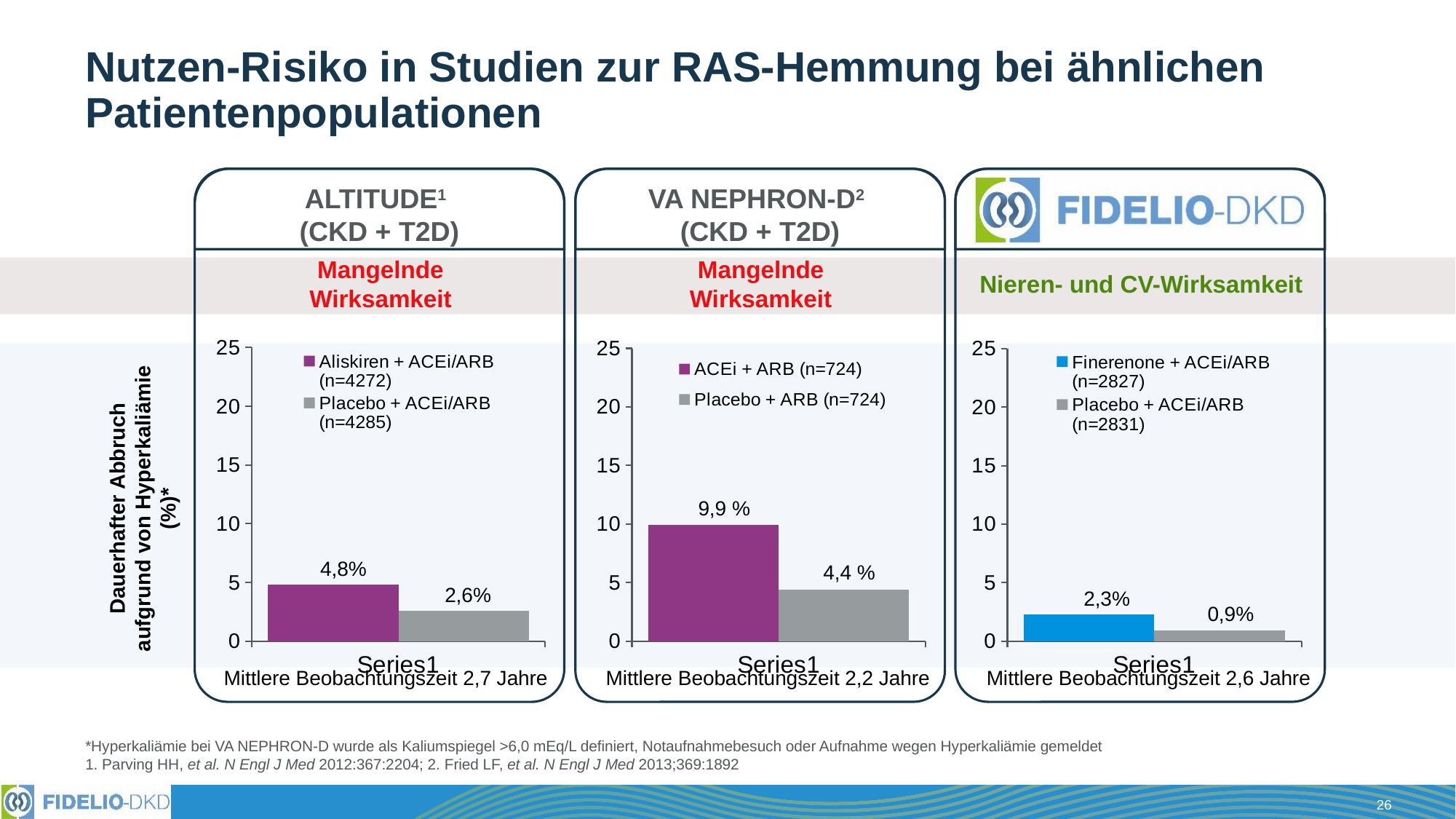
In the ALTITUDE chart, what is the value for Aliskiren + ACEi/ARB (n=4272)? 4,8% In the VA NEPHRON-D chart, what is the value for Placebo + ARB (n=724)? 4,4 % In the FIDELIO-DKD chart, what colour is the bar for Finerenone + ACEi/ARB? Blue In the VA NEPHRON-D chart, what is the value for ACEi + ARB (n=724)? 9,9 % In the FIDELIO-DKD chart, what is the value for Placebo + ACEi/ARB (n=2831)? 0,9% In the FIDELIO-DKD chart, what is the value for Finerenone + ACEi/ARB (n=2827)? 2,3% In the FIDELIO-DKD chart, which series has the higher value, Finerenone + ACEi/ARB or Placebo + ACEi/ARB? Finerenone + ACEi/ARB What kind of chart is the ALTITUDE chart? Bar chart How many series does the legend of the VA NEPHRON-D chart list? 2 In the ALTITUDE chart, what is the value for Placebo + ACEi/ARB (n=4285)? 2,6% In the ALTITUDE chart, what is the difference between the Aliskiren + ACEi/ARB value and the Placebo + ACEi/ARB value? 2,2 percentage points In the VA NEPHRON-D chart, what is the difference between the ACEi + ARB value and the Placebo + ARB value? 5,5 percentage points